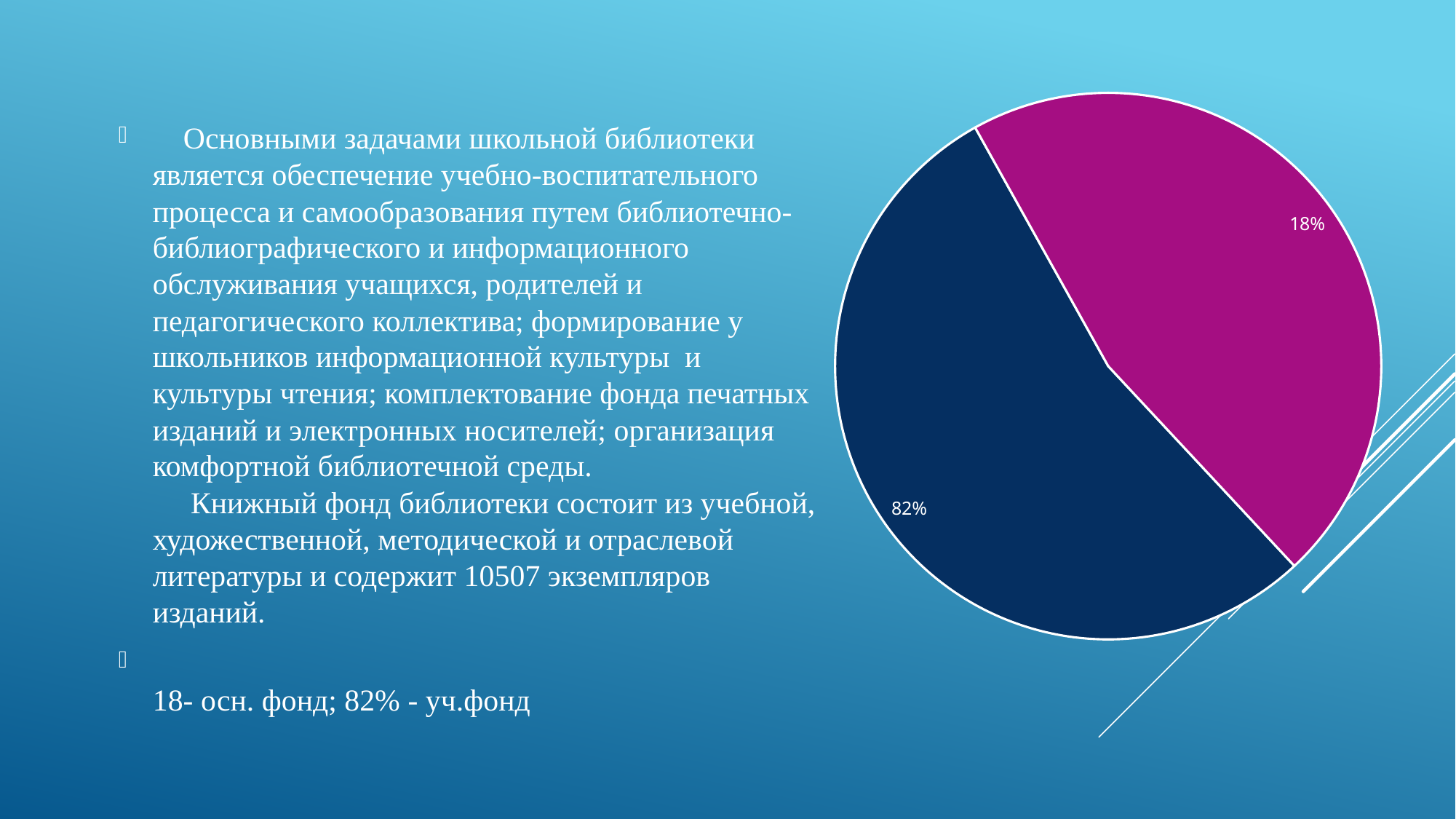
Does the pie chart have a legend? No Which slice of the pie chart is the largest? 82% According to the slide text, what share of the fund is осн. фонд? 18% According to the slide text, what share of the fund is уч.фонд? 82% What kind of chart is shown on the slide? pie chart How many slices does the pie chart have? 2 Which is larger in the pie chart: the magenta slice or the dark blue slice? dark blue slice What percentage is shown on the magenta slice of the pie chart? 18% What colour is the slice labelled 18% in the pie chart? magenta What is the difference between the two slices of the pie chart? 64% Which slice of the pie chart is the smallest? 18% What percentage is shown on the dark blue slice of the pie chart? 82%